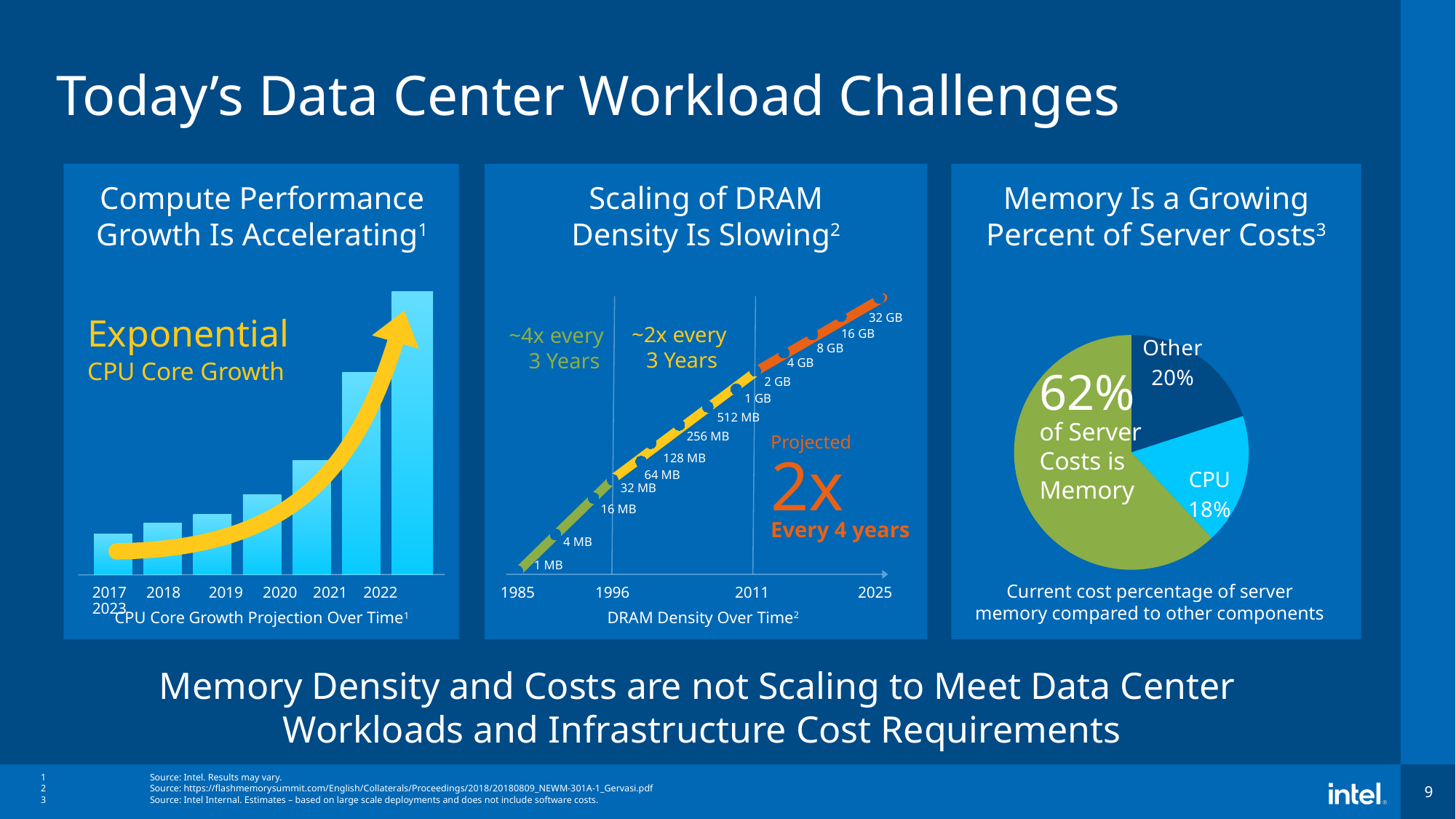
In the pie chart on the right, which component has the largest share of server costs? Memory In the pie chart on the right, how many percentage points larger is the Memory share than the CPU share? 44 percentage points In the pie chart on the right, which slice is the smallest? CPU What kind of chart is used in the left panel, CPU Core Growth Projection Over Time? Bar chart In the left bar chart (CPU Core Growth Projection Over Time), how many years are shown on the x axis? 7 In the pie chart on the right, what share of server costs is labelled Other? 20% In the middle chart (DRAM Density Over Time), what is the lowest DRAM density labelled on the chart? 1 MB In the pie chart on the right, how many slices are there? 3 In the left bar chart (CPU Core Growth Projection Over Time), do the bars rise or fall from 2017 to 2023? Rise In the pie chart on the right (Memory Is a Growing Percent of Server Costs), what percentage of server costs is memory? 62% In the pie chart on the right, what share of server costs is CPU? 18% In the middle chart (DRAM Density Over Time), what is the highest DRAM density labelled on the chart? 32 GB